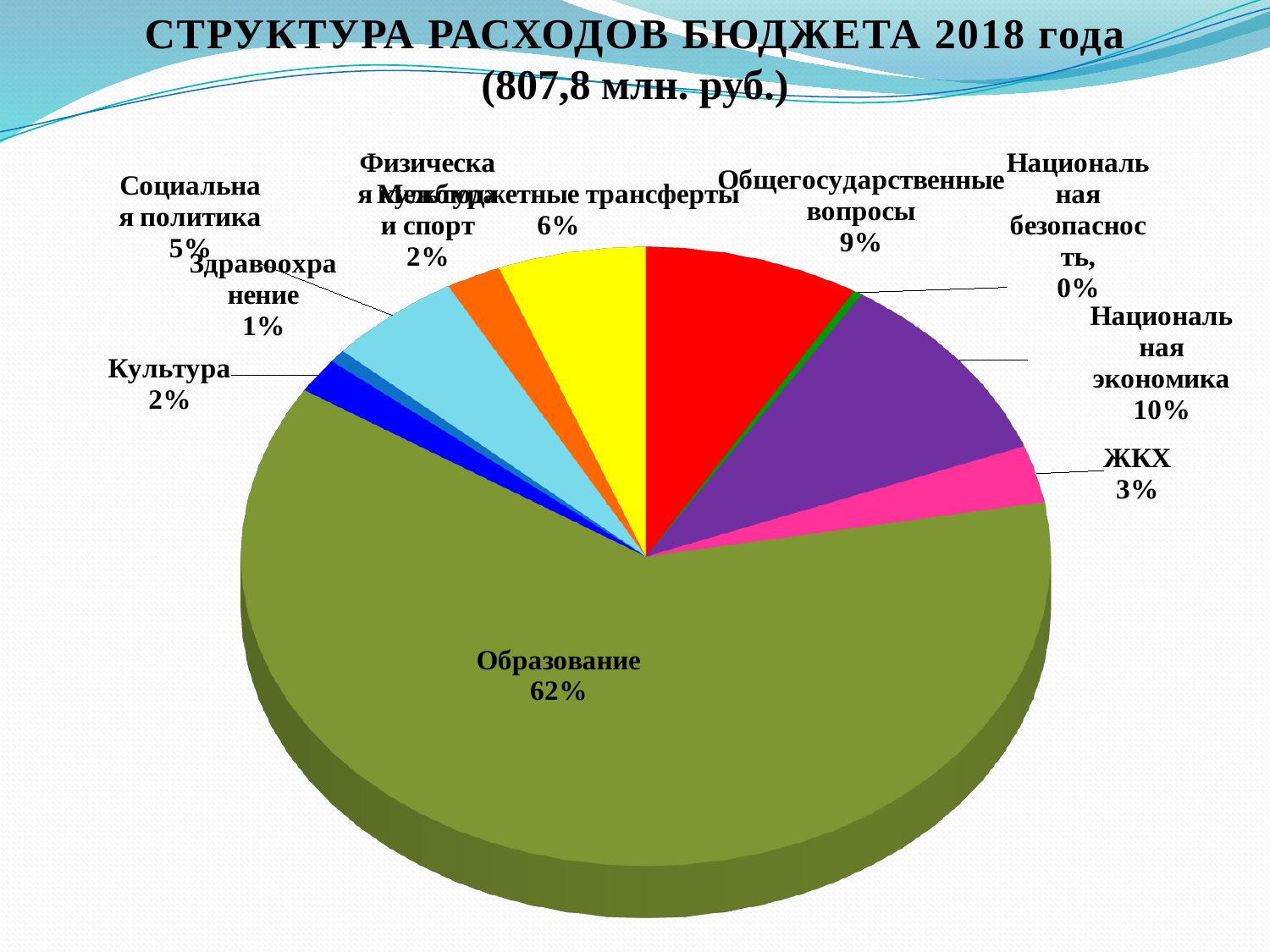
What share of the pie does ЖКХ take? 3% What kind of chart is shown on the slide? Pie chart Which category has the largest share of the pie? Образование What is the difference in percentage points between Образование and Национальная экономика? 52 Which category has the smallest share of the pie? Национальная безопасность What share of the pie does Социальная политика take? 5% What share of the pie does Общегосударственные вопросы take? 9% What total budget amount is given in the chart title? 807,8 млн. руб. Which is larger, the share for Общегосударственные вопросы or the share for Межбюджетные трансферты? Общегосударственные вопросы